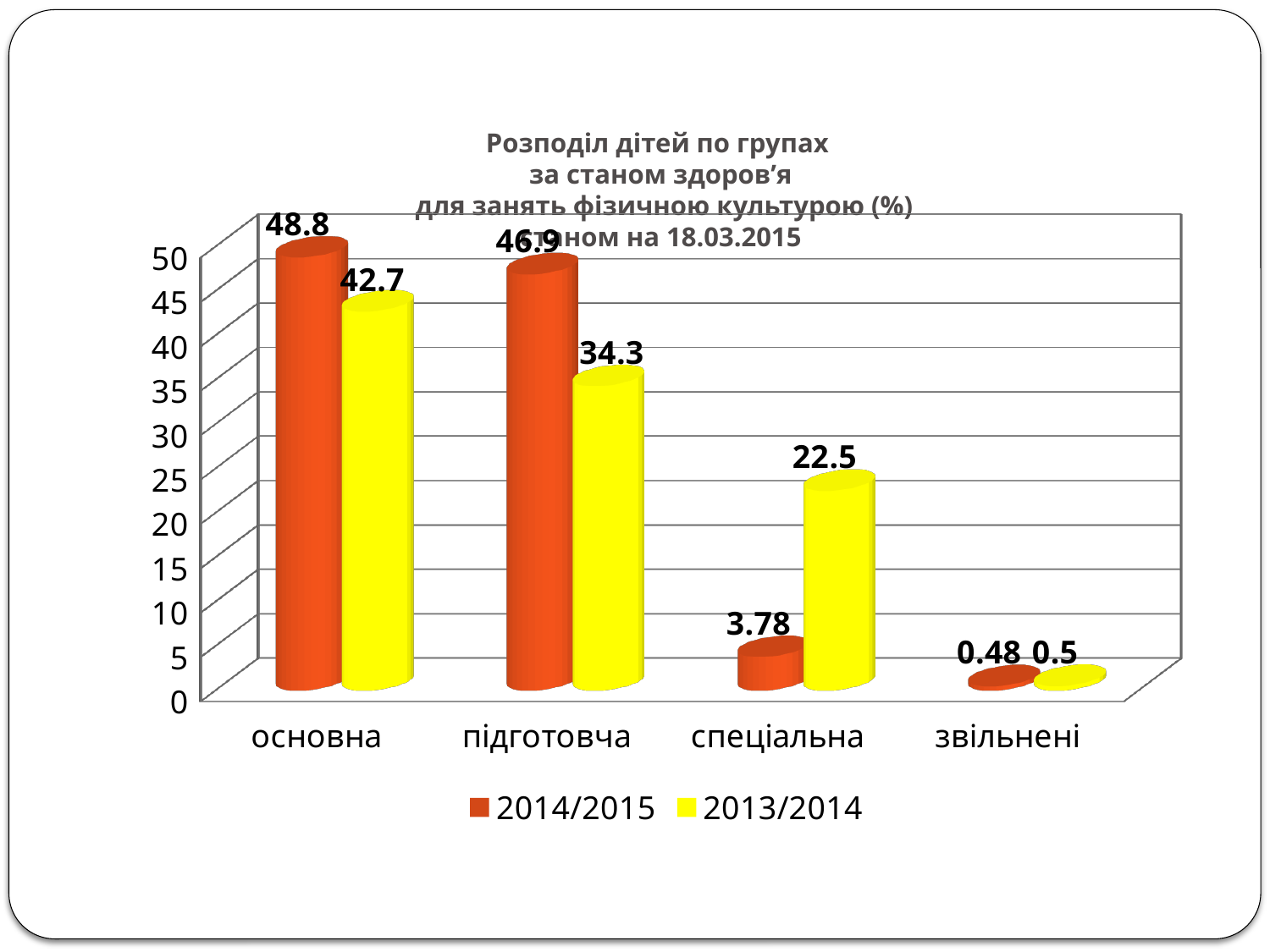
How many series does the legend list? 2 Which category has the lowest value in the 2014/2015 series? звільнені Which colour represents the 2013/2014 series? yellow What is the value for спеціальна in the 2014/2015 series? 3.78 For спеціальна, which series has the larger value, 2014/2015 or 2013/2014? 2013/2014 What is the value for звільнені in the 2013/2014 series? 0.5 What is the difference between the 2014/2015 and 2013/2014 values for підготовча? 12.6 How many categories are shown on the x axis? 4 What kind of chart is shown on the slide? bar chart What is the value for підготовча in the 2013/2014 series? 34.3 Which category has the highest value in the 2013/2014 series? основна What is the value for основна in the 2014/2015 series? 48.8